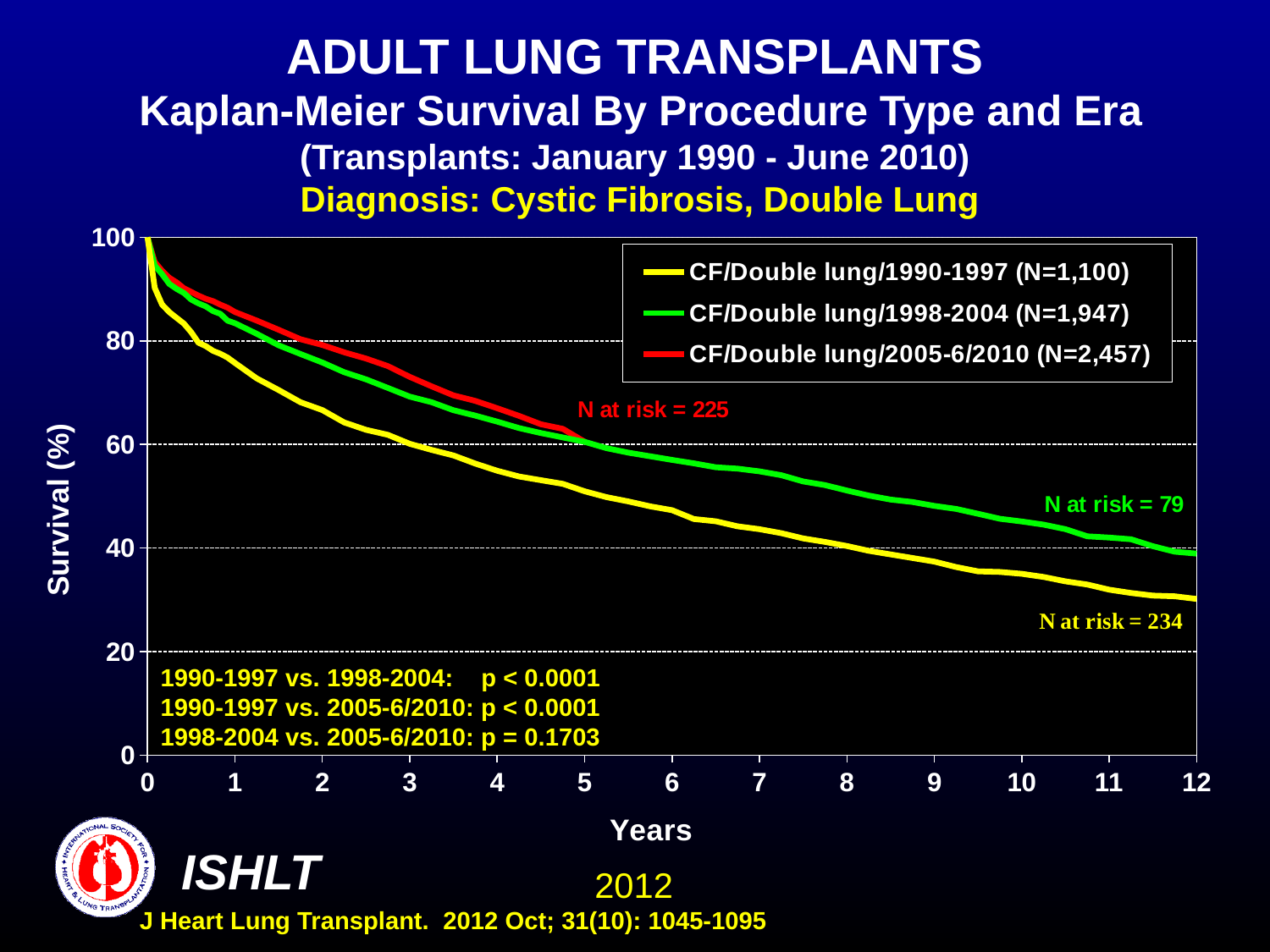
At 3 years, which has higher survival: CF/Double lung/2005-6/2010 or CF/Double lung/1990-1997? CF/Double lung/2005-6/2010 Which series has the lowest survival at 12 years? CF/Double lung/1990-1997 What is the N at risk shown for the CF/Double lung/2005-6/2010 curve? 225 What is the N at risk shown for the CF/Double lung/1998-2004 curve? 79 Is the survival for CF/Double lung/2005-6/2010 at 3 years greater or less than 60? greater Which series has the largest N in the legend? CF/Double lung/2005-6/2010 How many series does the legend list? 3 What kind of chart is shown on the slide? Line chart What is the N for the CF/Double lung/1990-1997 series in the legend? 1,100 What is the N for the CF/Double lung/2005-6/2010 series in the legend? 2,457 Is the survival for CF/Double lung/1990-1997 at 12 years greater or less than 40? less Do the survival curves rise or fall as years increase? Fall